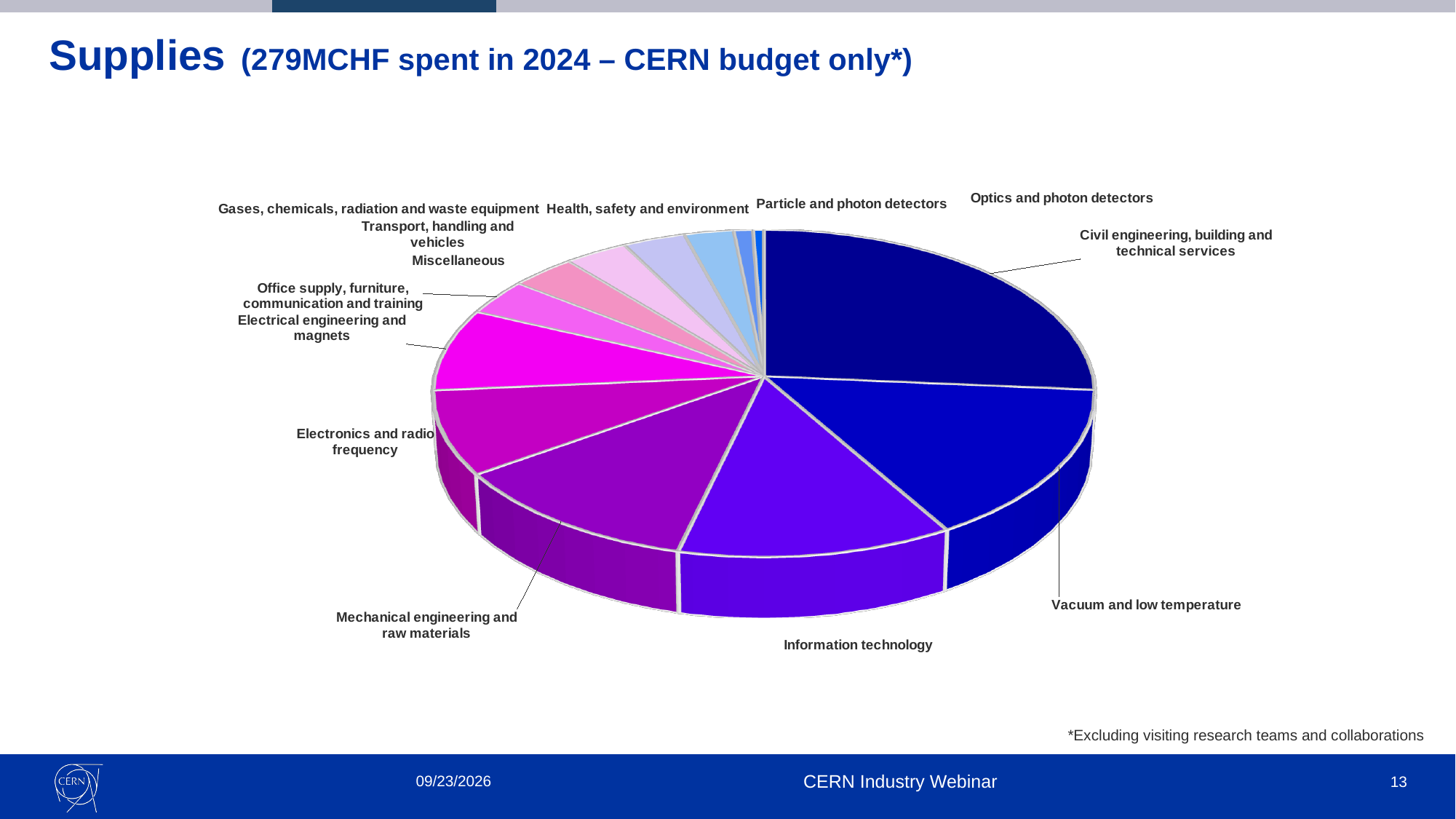
Which slice is larger: Information technology or Health, safety and environment? Information technology How many categories (slices) does the pie chart show? 13 Which slice is larger: Electronics and radio frequency or Gases, chemicals, radiation and waste equipment? Electronics and radio frequency Which category has the largest slice of the pie chart? Civil engineering, building and technical services Which slice is larger: Vacuum and low temperature or Transport, handling and vehicles? Vacuum and low temperature What is the title of the slide containing the pie chart? Supplies According to the slide title, how much was spent on supplies in 2024 from the CERN budget? 279MCHF What kind of chart is shown on the slide? pie chart